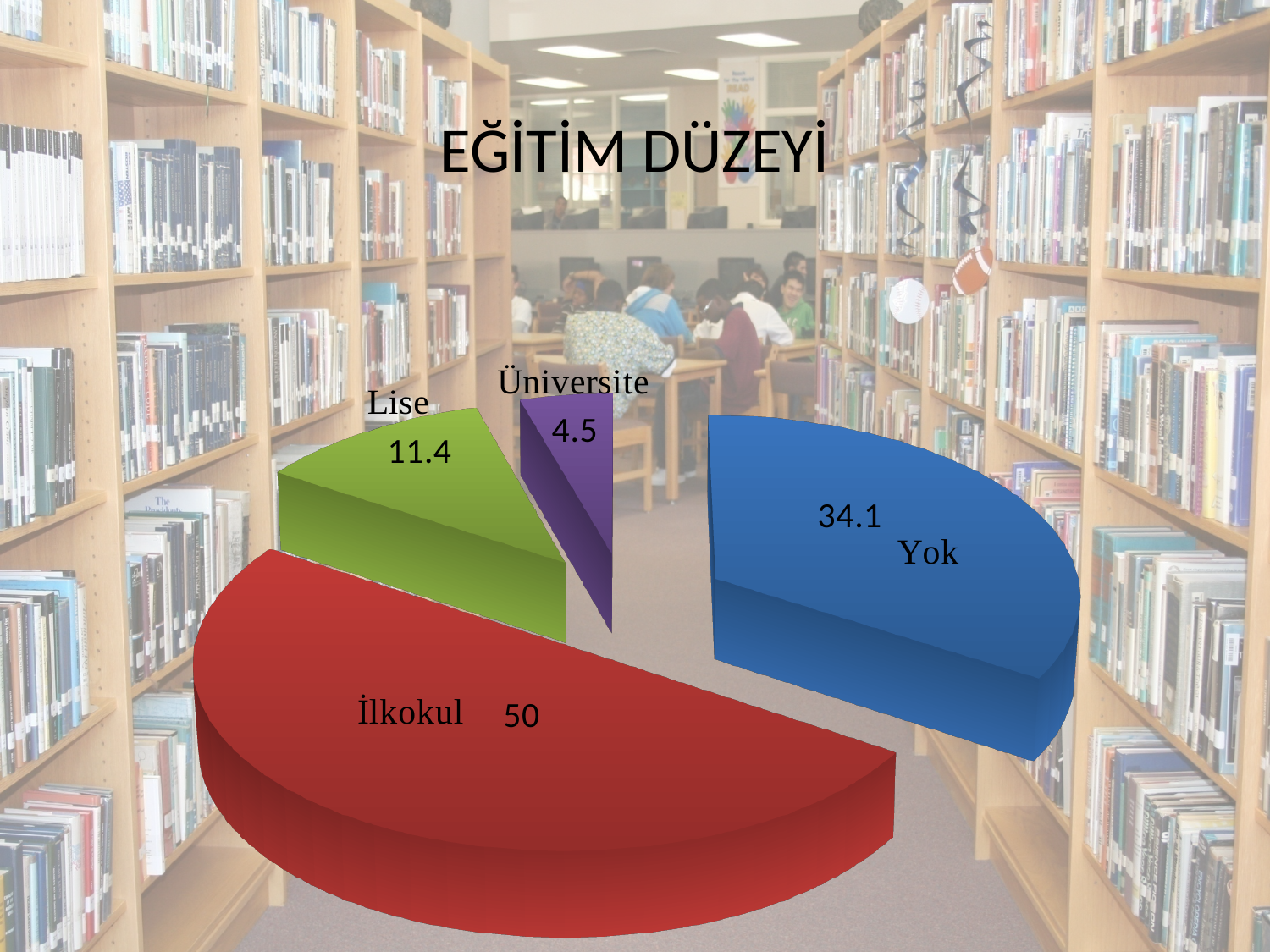
Which category has the largest slice? İlkokul How many categories are shown in the pie chart? 4 What is the title of the chart? EĞİTİM DÜZEYİ Which category has the smallest slice? Üniversite What is the value for Lise? 11.4 Which is larger, the value for Yok or the value for Lise? Yok What is the value for Üniversite? 4.5 What is the difference between the values for Lise and Üniversite? 6.9 What kind of chart is shown on the slide? Pie chart What is the value for İlkokul? 50 What is the difference between the values for İlkokul and Yok? 15.9 What is the value for Yok? 34.1